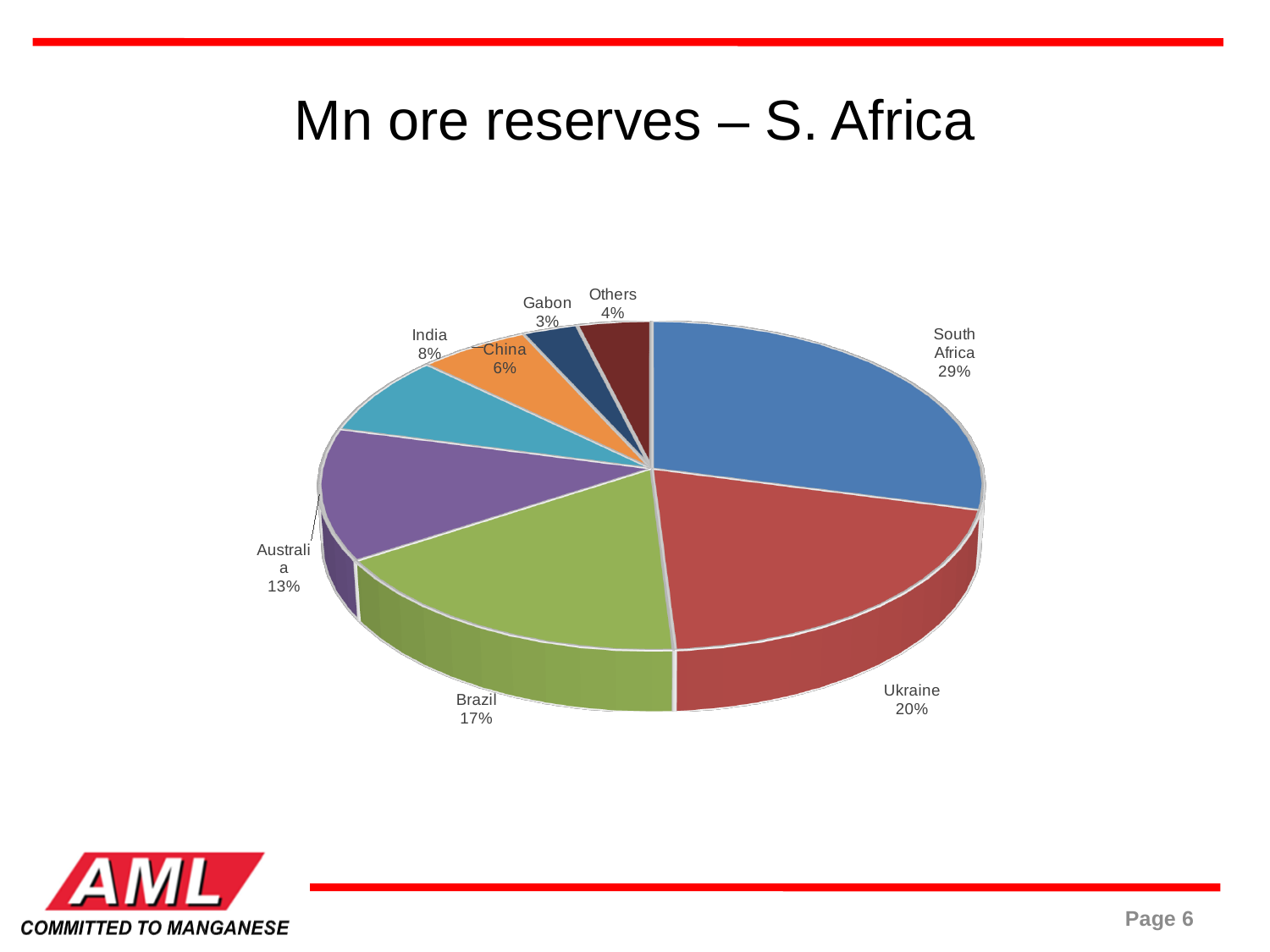
What share of Mn ore reserves does Australia hold? 13% What share of Mn ore reserves does Ukraine hold? 20% What is the difference in percentage points between South Africa's share and Ukraine's share? 9 What share of Mn ore reserves does South Africa hold? 29% Which slice of the pie is the smallest? Gabon What share of Mn ore reserves does Brazil hold? 17% What type of chart is shown on the slide? Pie chart How many slices does the pie chart have? 8 Which country has the largest share of Mn ore reserves? South Africa What share of Mn ore reserves does Gabon hold? 3% Which has a larger share of Mn ore reserves, Brazil or Australia? Brazil What share of Mn ore reserves does India hold? 8%